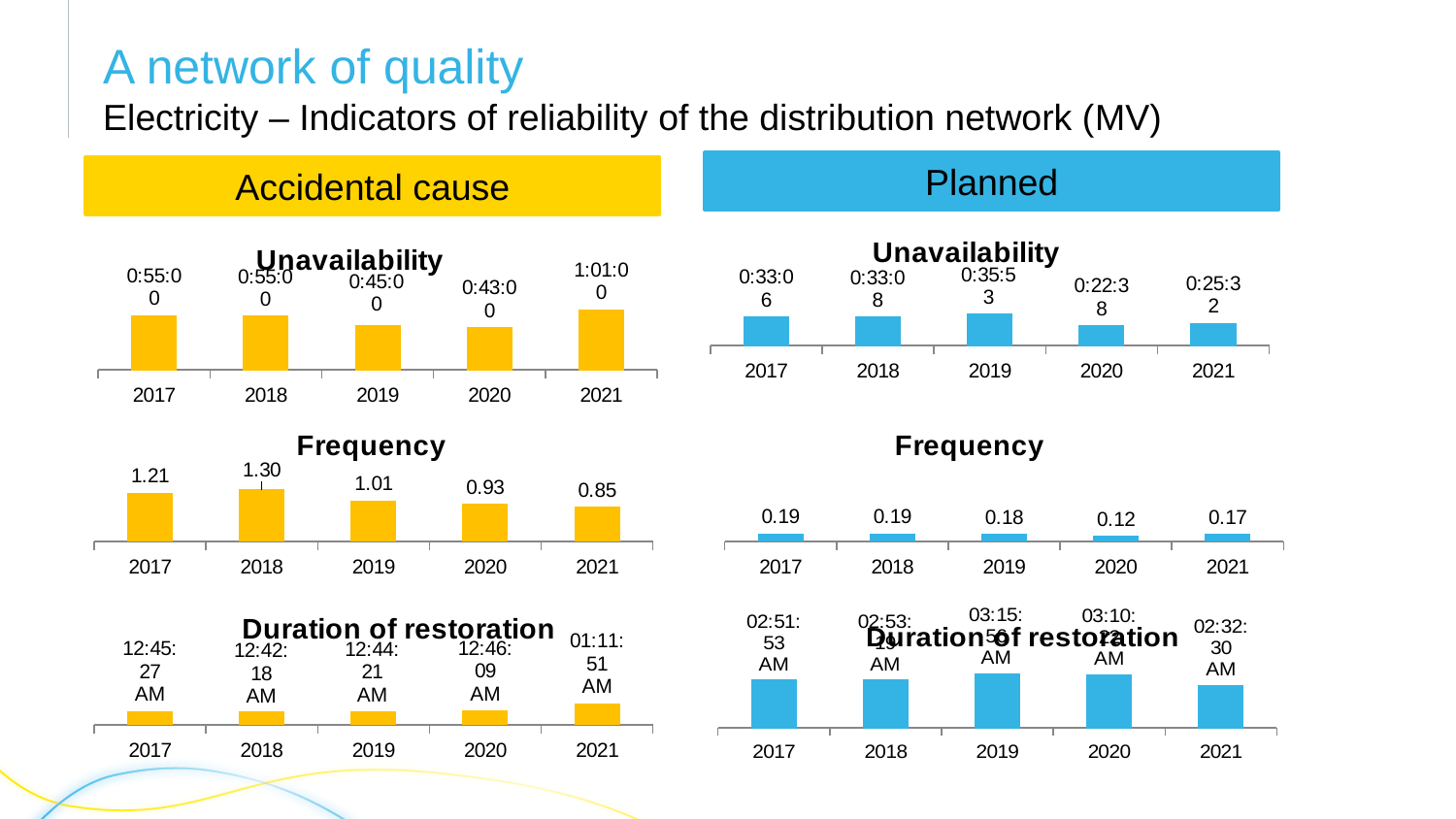
In the Planned Frequency chart, what is the value for 2020? 0.12 In the Accidental cause Unavailability chart, what is the value for 2021? 1:01:00 In the Accidental cause Unavailability chart, which year has the highest value? 2021 In the Accidental cause Frequency chart, which year has the lowest value? 2021 How many years are shown in the Accidental cause Frequency chart? 5 In the Planned Frequency chart, which is larger, the value for 2019 or the value for 2020? 2019 In the Accidental cause Duration of restoration chart, what is the value for 2021? 01:11:51 AM In the Planned Unavailability chart, which year has the highest value? 2019 In the Accidental cause Frequency chart, what is the difference between the 2017 and 2021 values? 0.36 In the Accidental cause Frequency chart, what is the value for 2018? 1.30 In the Planned Unavailability chart, what is the value for 2020? 0:22:38 What kind of chart is the Planned Frequency chart? bar chart